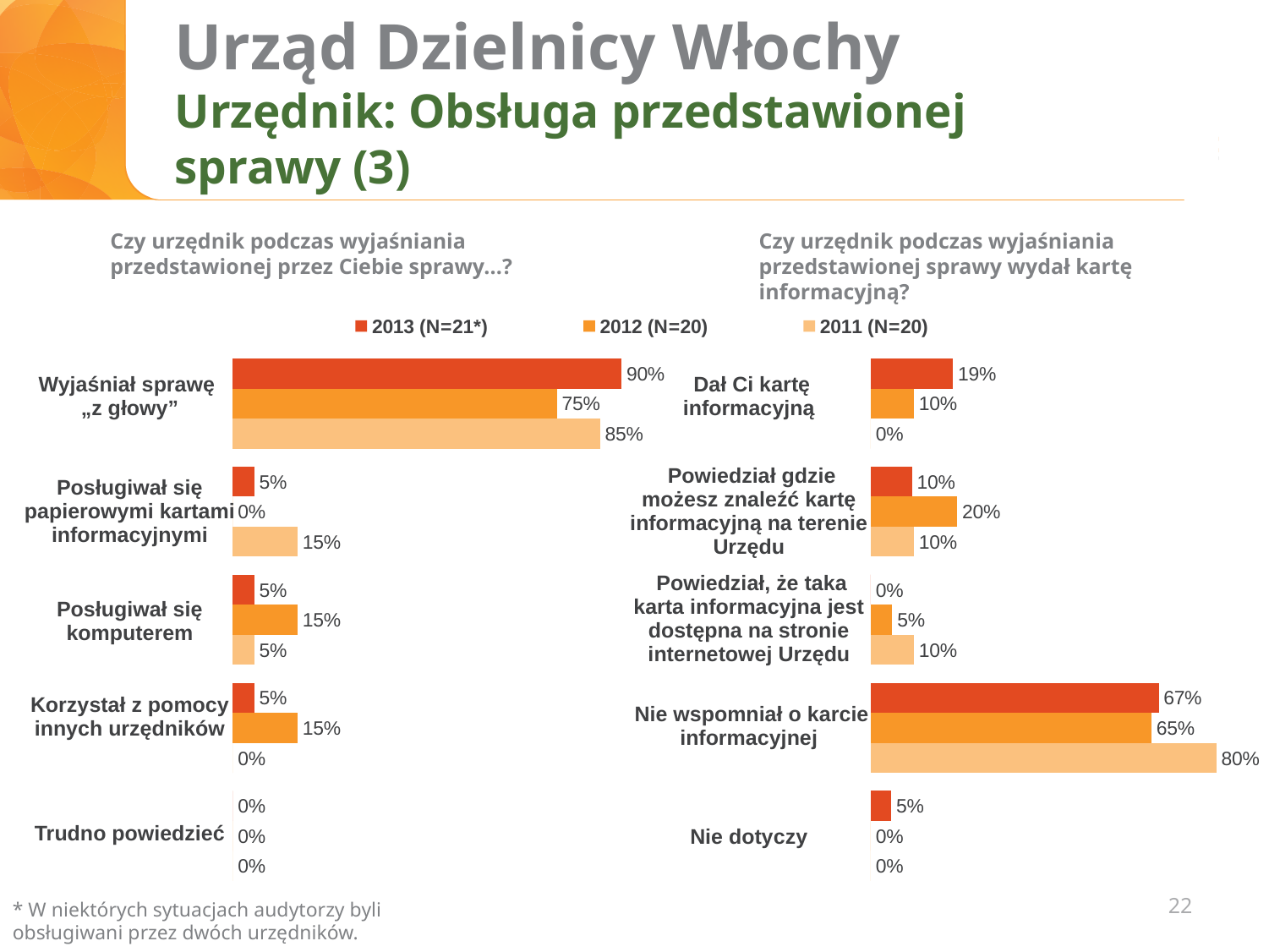
In the left chart, what is the difference between the 2013 and 2012 values for "Wyjaśniał sprawę „z głowy”"? 15 percentage points In the right chart, what is the 2013 value for "Dał Ci kartę informacyjną"? 19% How many categories are shown in the left chart? 5 In the right chart ("Czy urzędnik podczas wyjaśniania przedstawionej sprawy wydał kartę informacyjną?"), what is the 2011 value for "Nie wspomniał o karcie informacyjnej"? 80% In the right chart, what is the difference between the 2011 and 2013 values for "Nie wspomniał o karcie informacyjnej"? 13 percentage points How many series does the legend list? 3 In the right chart, which is larger for "Powiedział gdzie możesz znaleźć kartę informacyjną na terenie Urzędu": the 2012 value or the 2013 value? 2012 In the left chart ("Czy urzędnik podczas wyjaśniania przedstawionej przez Ciebie sprawy...?"), what is the 2013 value for "Wyjaśniał sprawę „z głowy”"? 90% In the right chart, which category has the highest 2012 value? Nie wspomniał o karcie informacyjnej In the left chart, what is the 2012 value for "Posługiwał się komputerem"? 15% In the left chart, which category has the highest 2011 value? Wyjaśniał sprawę „z głowy” What type of chart is used on this slide? Bar chart